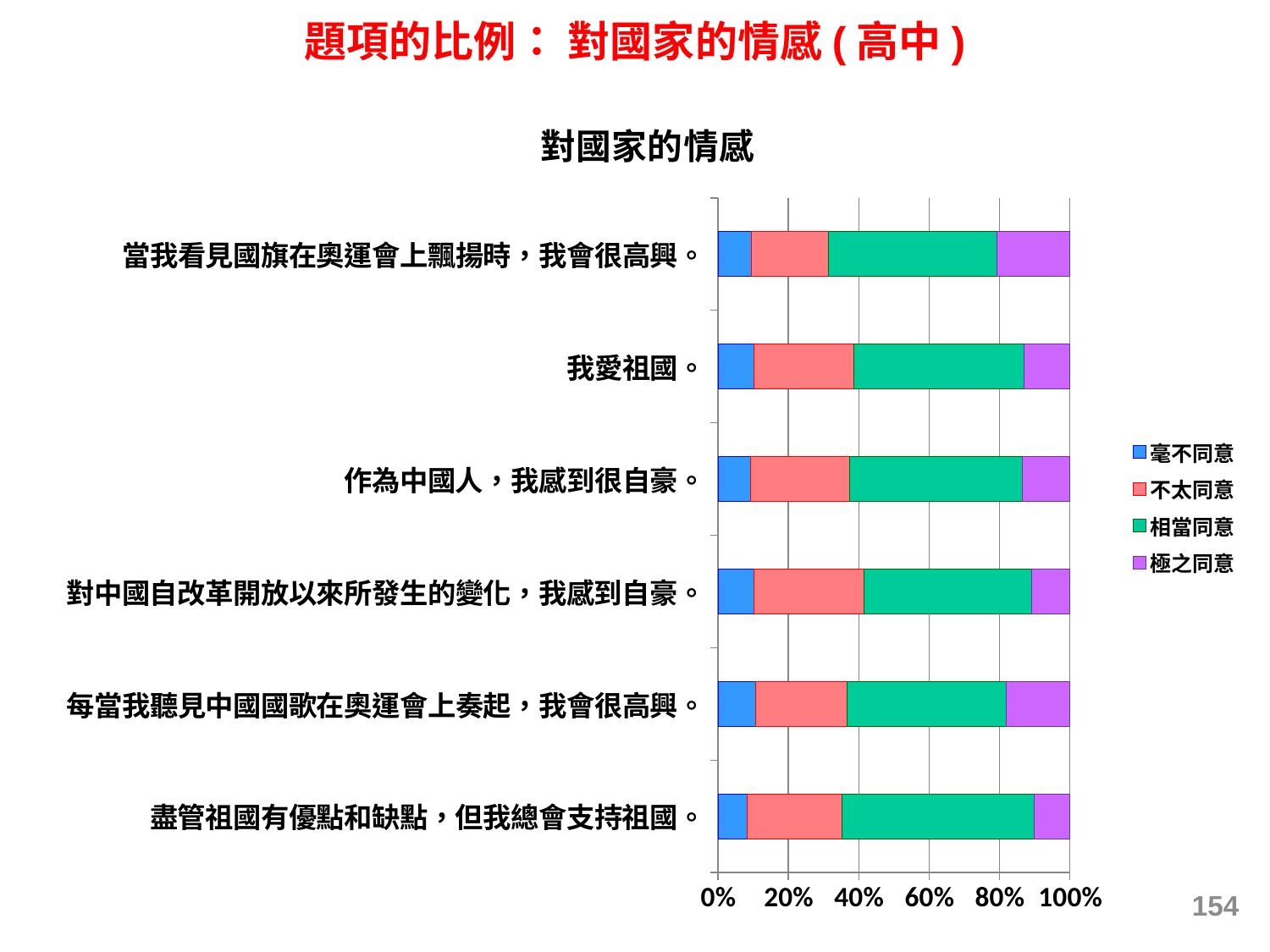
What is the title of the chart? 對國家的情感 Which statement has the largest 極之同意 segment? 當我看見國旗在奧運會上飄揚時，我會很高興。 How many series does the legend list? 4 In the bar for 盡管祖國有優點和缺點，但我總會支持祖國。, does the 相當同意 segment end at a point greater or less than 80%? greater Is the 不太同意 segment larger for 對中國自改革開放以來所發生的變化，我感到自豪。 or for 當我看見國旗在奧運會上飄揚時，我會很高興。? 對中國自改革開放以來所發生的變化，我感到自豪。 Is the 毫不同意 share for 我愛祖國。 greater or less than 20%? less In the bar for 每當我聽見中國國歌在奧運會上奏起，我會很高興。, is the combined share of 毫不同意 and 不太同意 greater or less than 20%? greater What kind of chart is shown on the slide? bar chart Which series is shown in blue in the chart? 毫不同意 Is the 極之同意 segment larger for 當我看見國旗在奧運會上飄揚時，我會很高興。 or for 我愛祖國。? 當我看見國旗在奧運會上飄揚時，我會很高興。 How many statements (categories) are plotted in the chart? 6